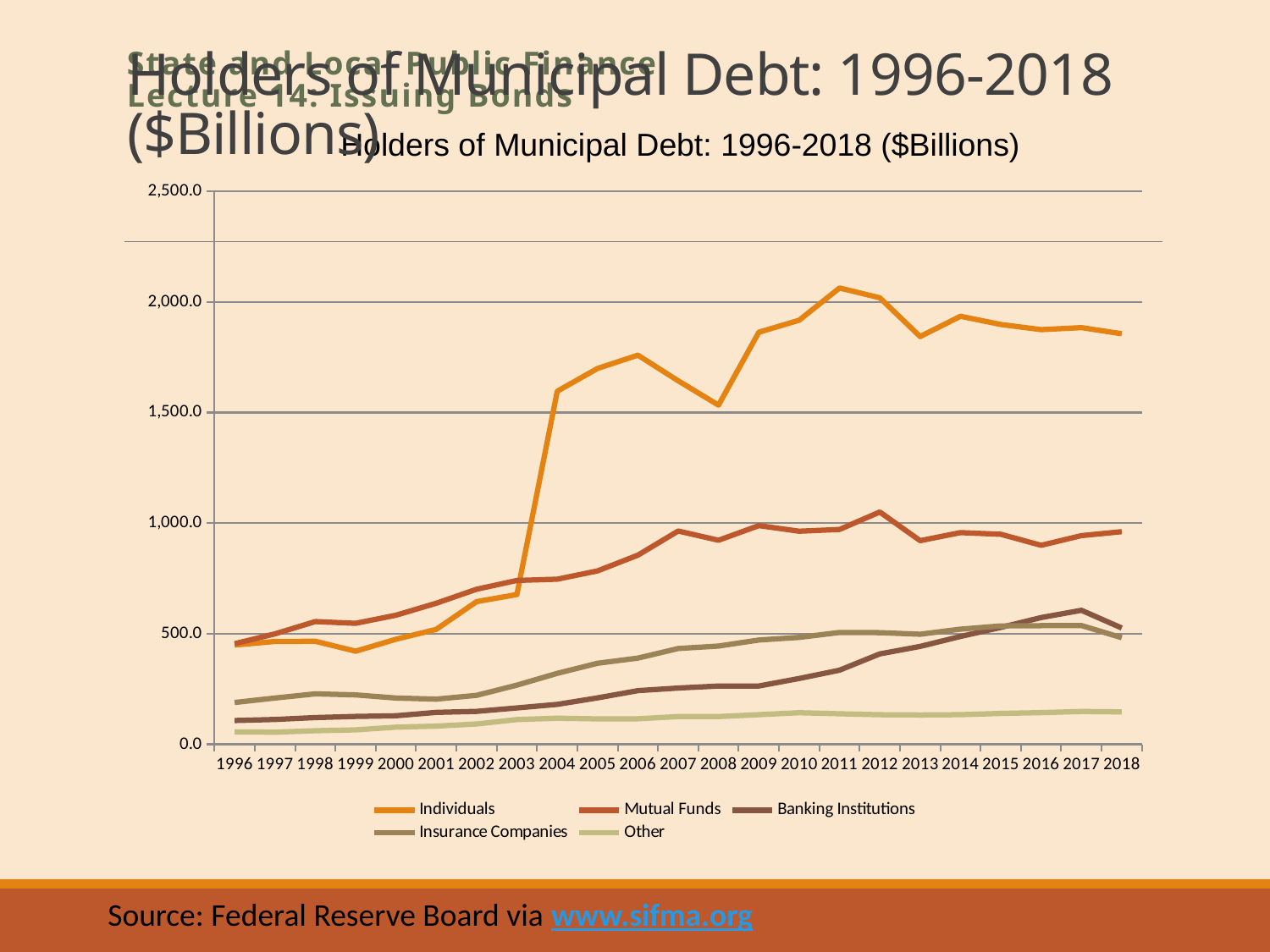
What is the title of the chart? Holders of Municipal Debt: 1996-2018 ($Billions) How many series does the legend list? 5 What kind of chart is shown on the slide? line chart Is the value for Individuals in 2004 greater or less than 1,500? greater Is the value for Mutual Funds in 2016 greater or less than 1,000? less Which series has the highest value in 2018? Individuals How many years are plotted along the x axis? 23 Which series has the lowest value in 2018? Other Is the value for Other in 2018 greater or less than 500? less In 2010, which is larger: Individuals or Mutual Funds? Individuals Does the Banking Institutions line rise or fall from 1996 to 2017? rise In 2005, which is larger: Banking Institutions or Insurance Companies? Insurance Companies